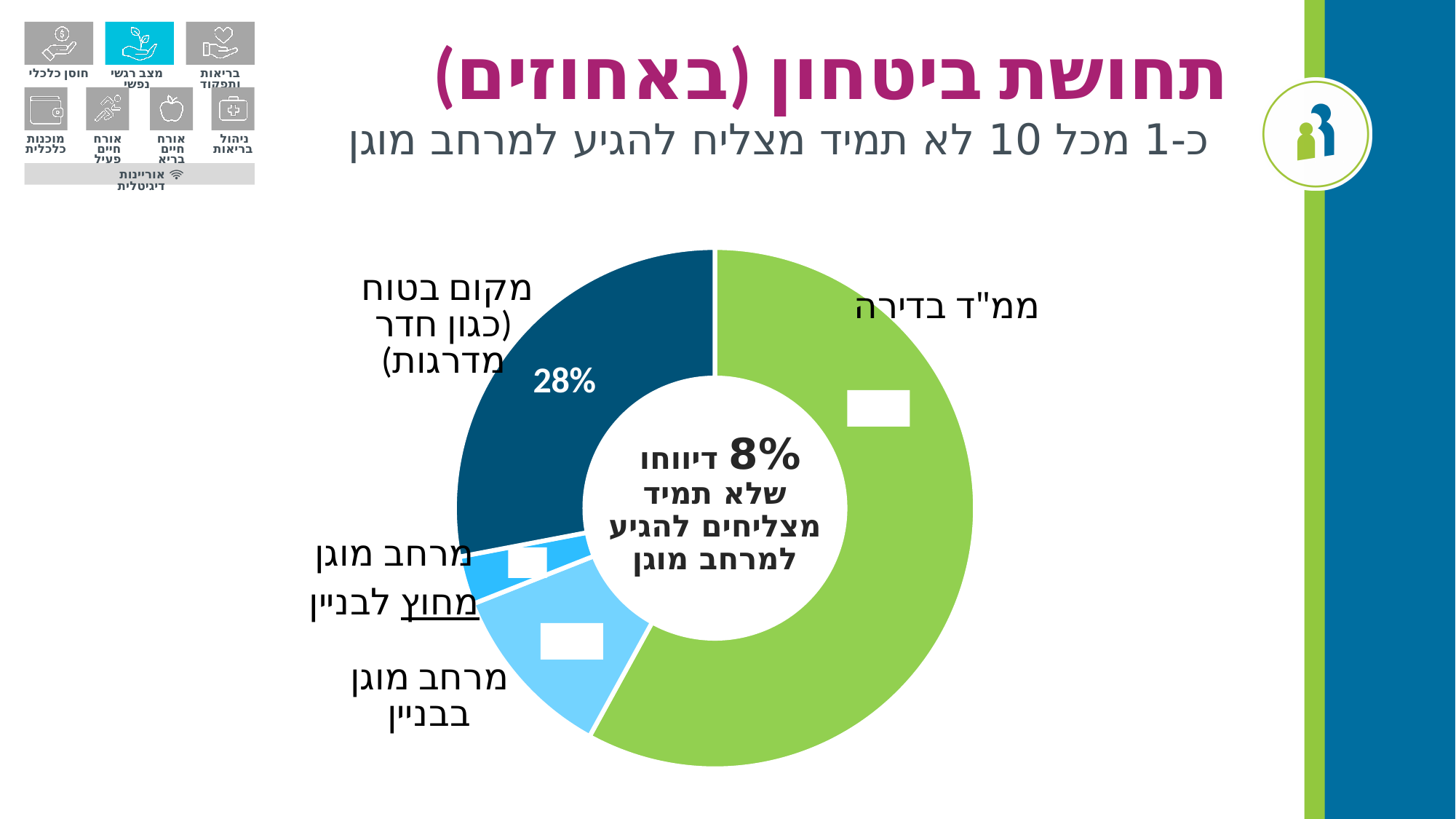
Which slice is larger: מרחב מוגן בבניין or מרחב מוגן מחוץ לבניין? מרחב מוגן בבניין How many categories (slices) does the chart have? 4 Does the slice for ממ"ד בדירה take up more or less than half of the chart? more What percentage is shown for the slice מקום בטוח (כגון חדר מדרגות)? 28% What is the title of the slide? תחושת ביטחון (באחוזים) Which category has the smallest slice of the chart? מרחב מוגן מחוץ לבניין Which category has the largest slice of the chart? ממ"ד בדירה Which slice is larger: ממ"ד בדירה or מקום בטוח (כגון חדר מדרגות)? ממ"ד בדירה What percentage is printed in the centre of the donut chart? 8% What kind of chart is shown on the slide? Pie (donut) chart